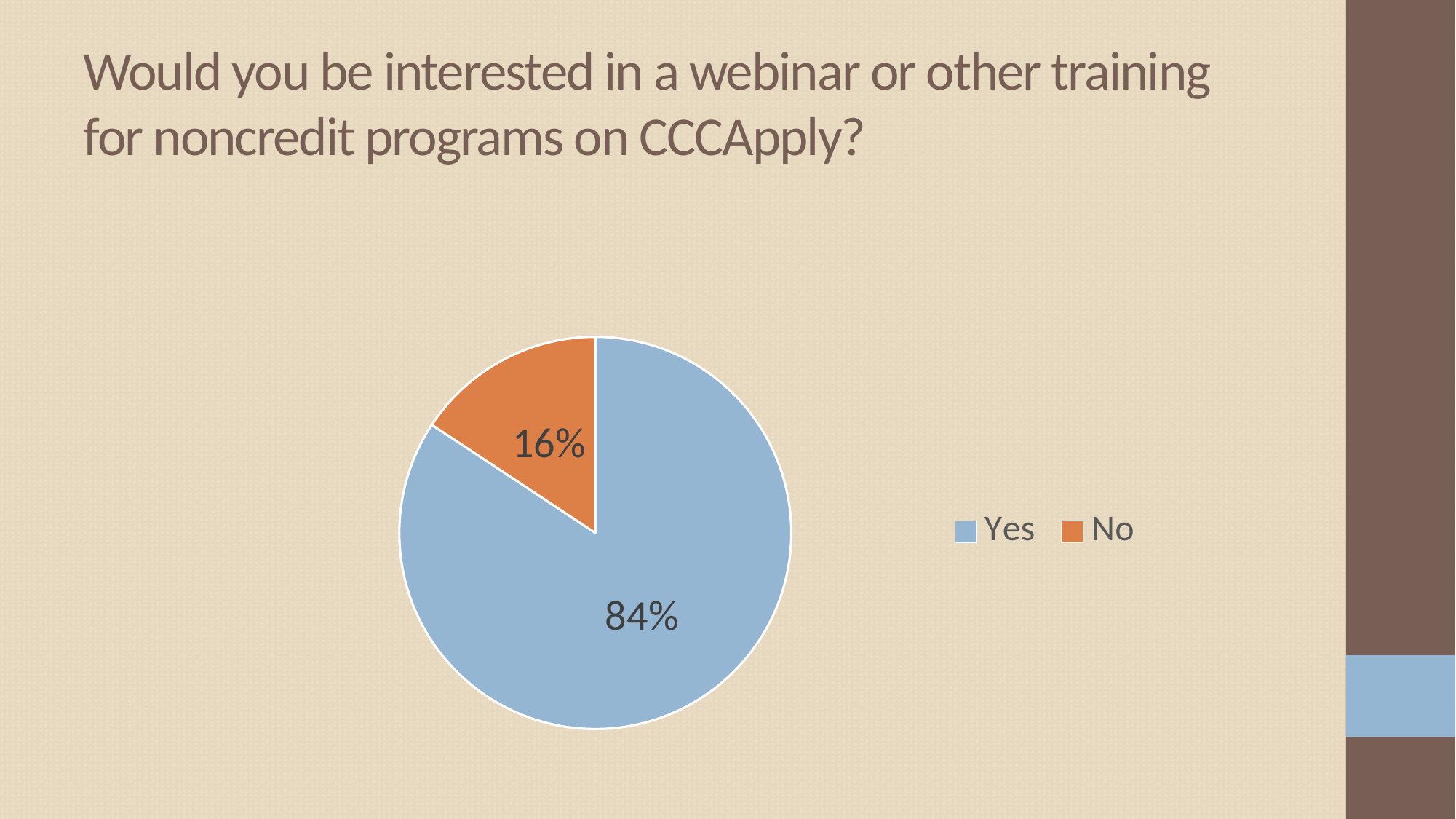
How many slices does the pie chart have? 2 What is the total of the two slice percentages shown? 100% Which slice of the pie is the largest? Yes What share of the pie is labelled "No"? 16% What colour is the Yes slice? blue What share of the pie is labelled "Yes"? 84% How many entries does the legend list? 2 What is the difference in percentage points between the Yes and No slices? 68 What kind of chart is shown on the slide? pie chart Which slice of the pie is the smallest? No Which is larger, the Yes slice or the No slice? Yes What colour is the No slice? orange